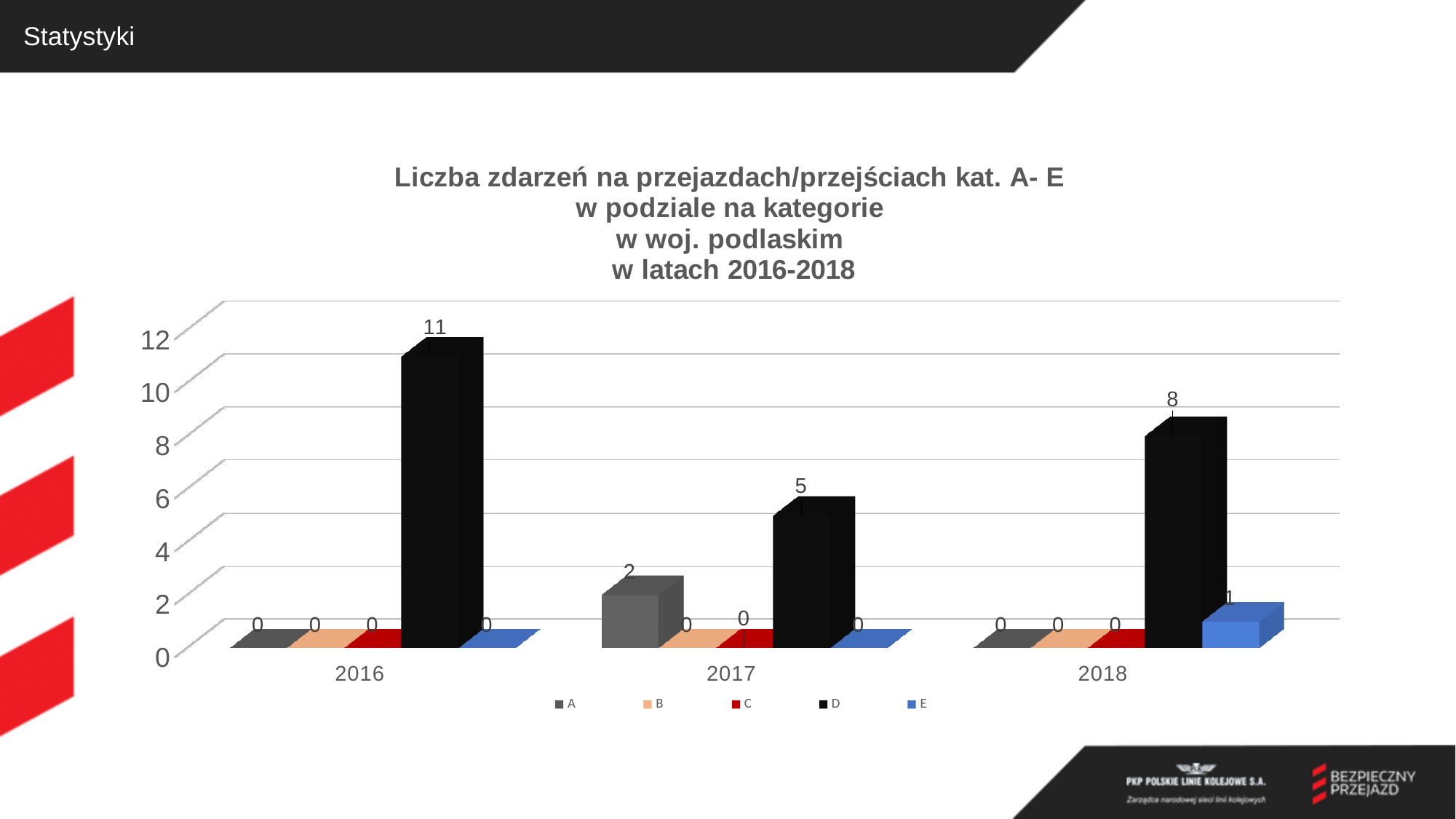
How many years are shown on the x axis? 3 How many series does the legend list? 5 What is the value for series D in 2018? 8 Which is larger: series A in 2017 or series E in 2018? series A in 2017 In which year is the value for series D lowest? 2017 What is the difference between the value for series D in 2016 and in 2018? 3 What is the value for series D in 2016? 11 What kind of chart is shown on the slide? bar chart What is the value for series E in 2018? 1 What is the value for series D in 2017? 5 In which year is the value for series D highest? 2016 What is the value for series A in 2017? 2